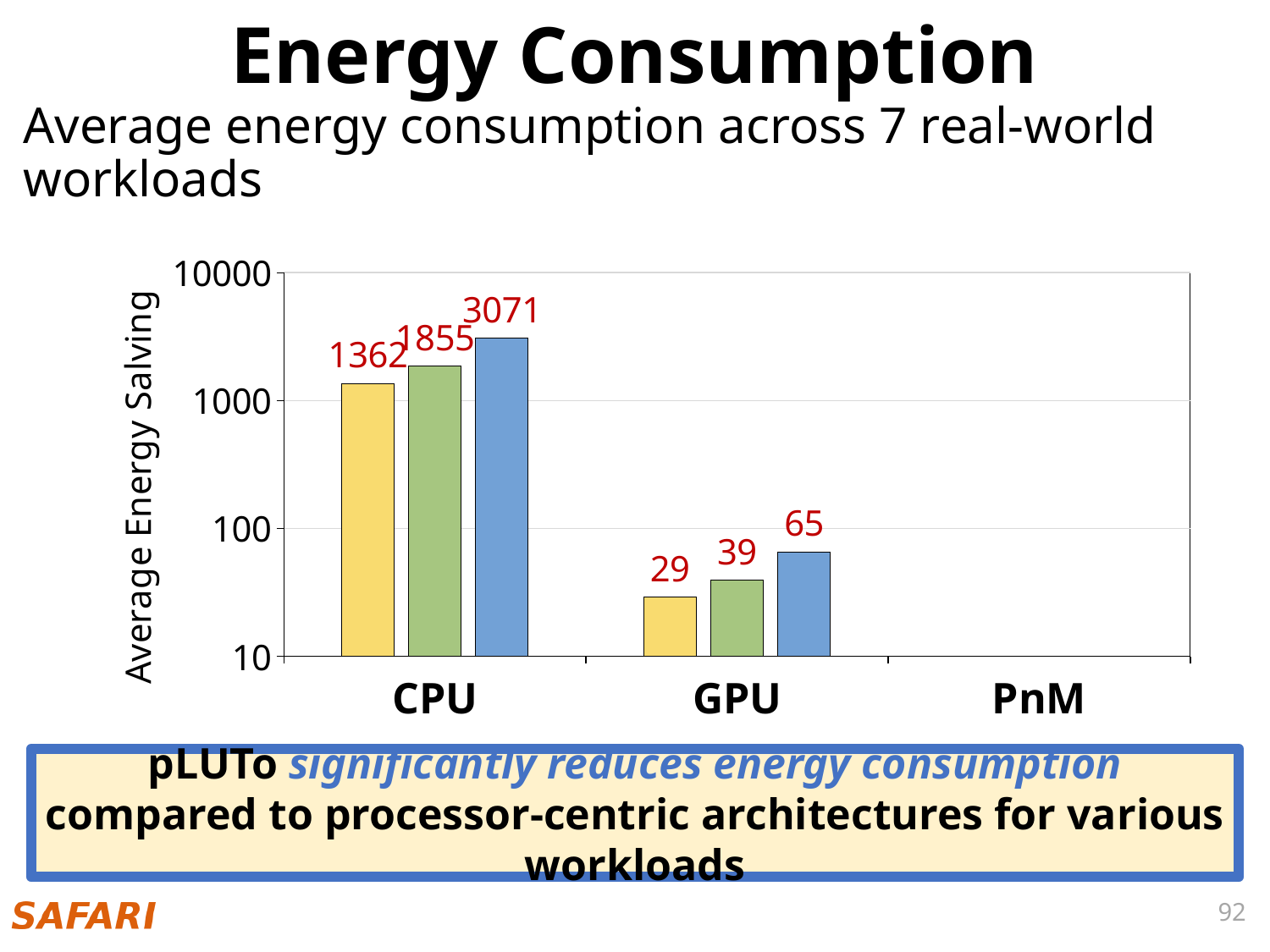
What is the value of the yellow bar for GPU? 29 Which is larger, the yellow bar for CPU or the blue bar for GPU? The yellow bar for CPU What is the value of the green bar for GPU? 39 What is the value of the blue bar for CPU? 3071 Is the value of the blue bar for GPU greater or less than 100? less How many categories are shown on the x axis? 3 Which bar has the lowest labelled value on the chart? The yellow bar for GPU (29) What is the difference between the blue bar and the green bar for GPU? 26 What is the difference between the blue bar and the yellow bar for CPU? 1709 What type of chart is shown on the slide? Bar chart What is the value of the green bar for CPU? 1855 Which bar has the highest value on the chart? The blue bar for CPU (3071)